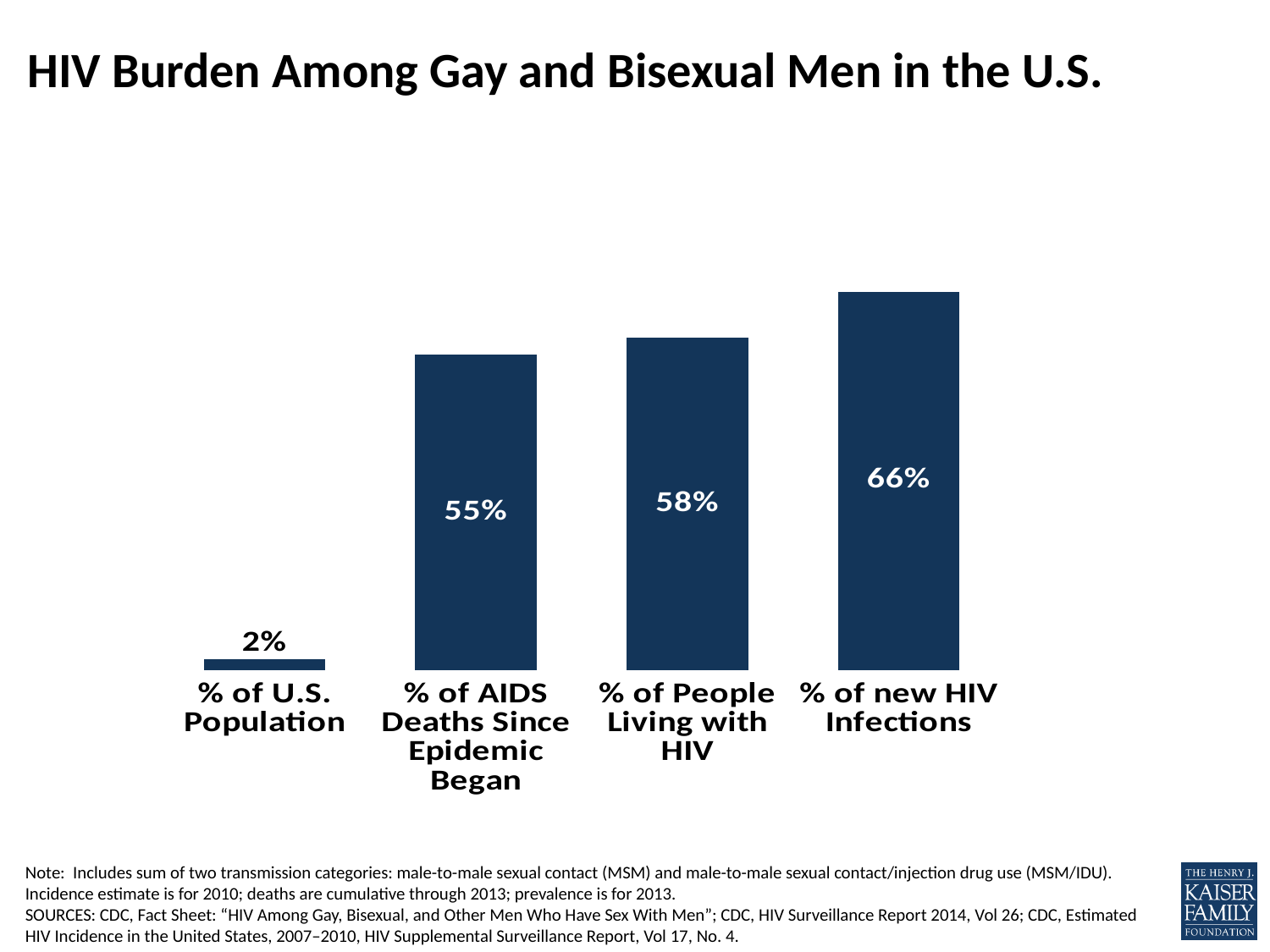
What is the value for % of new HIV Infections? 66% Do the values rise or fall from left to right across the categories? Rise Which category has the lowest value? % of U.S. Population What is the difference between % of People Living with HIV and % of AIDS Deaths Since Epidemic Began? 3% What is the value for % of AIDS Deaths Since Epidemic Began? 55% Which category has the highest value? % of new HIV Infections Which is larger: % of new HIV Infections or % of People Living with HIV? % of new HIV Infections What is the value for % of People Living with HIV? 58% How many categories are shown in the chart? 4 What kind of chart is shown on the slide? Bar chart What is the difference between % of new HIV Infections and % of U.S. Population? 64% What is the value for % of U.S. Population? 2%